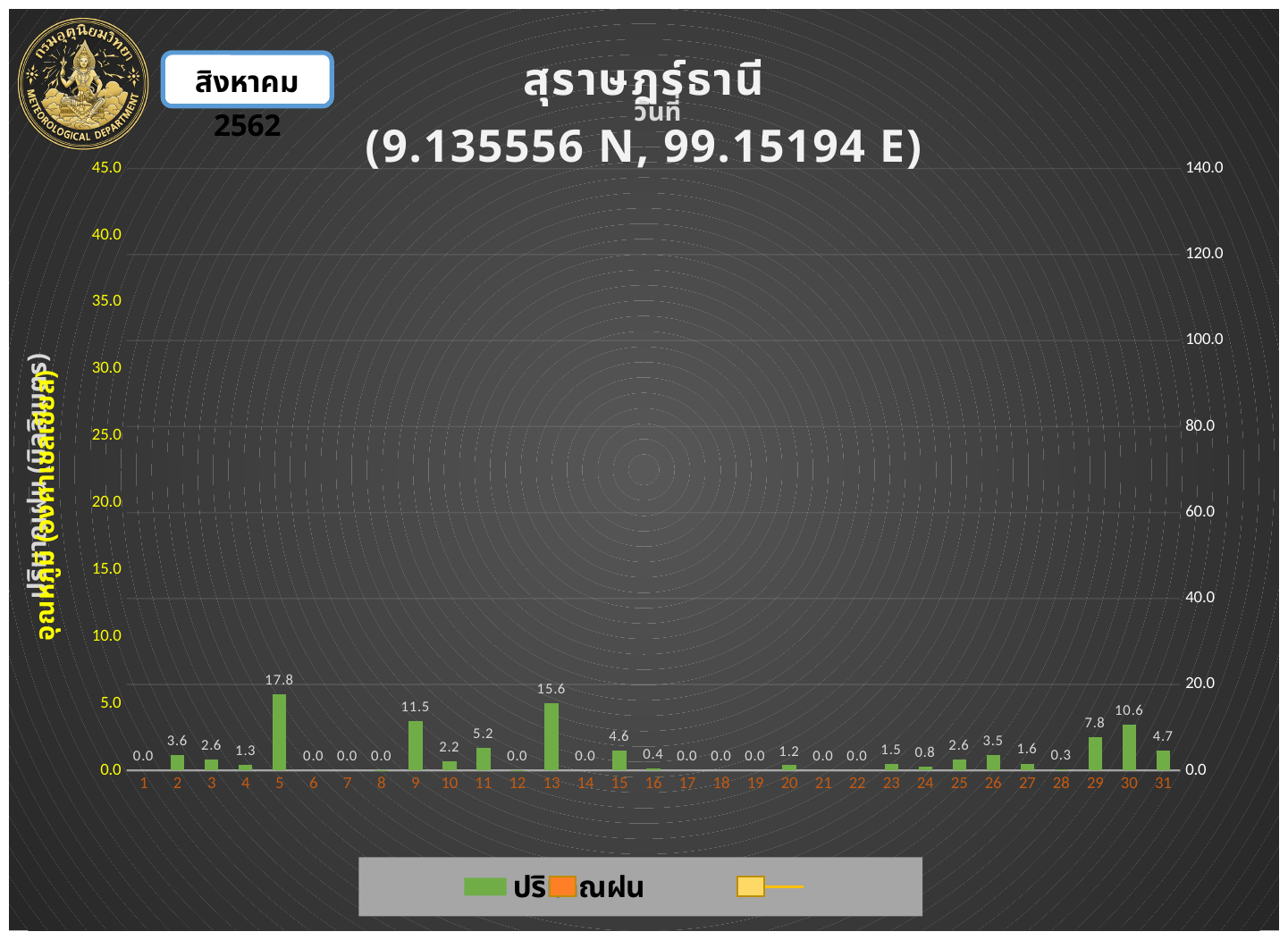
What is the rainfall value for day 5? 17.8 What is the difference between the rainfall values for day 9 and day 30? 0.9 What is the rainfall value for day 30? 10.6 What is the rainfall value for day 13? 15.6 What is the rainfall value for day 9? 11.5 What is the difference between the rainfall values for day 5 and day 13? 2.2 What colour are the rainfall (ปริมาณฝน) bars? green Which day has the highest rainfall value? 5 How many days are shown on the x axis? 31 Which has the larger rainfall value, day 9 or day 30? day 9 What kind of chart is shown on the slide? bar chart Which has the larger rainfall value, day 29 or day 31? day 29